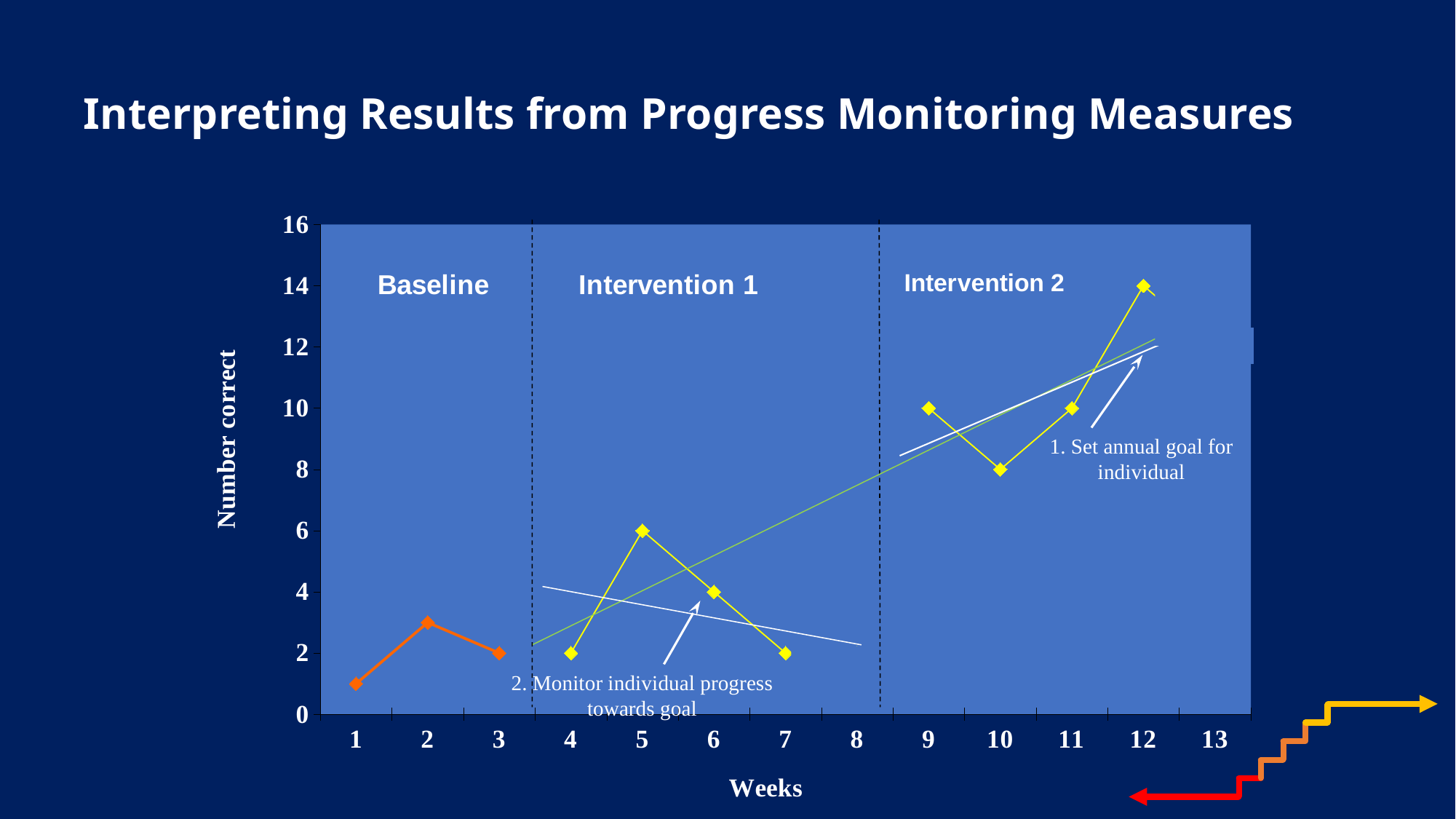
What is the number correct at week 12? 14 At which week is the number correct highest? 12 What is the number correct at week 10? 8 Is the number correct at week 2 greater or less than 4? less Which week has a higher number correct, week 9 or week 10? week 9 What is the difference between the number correct at week 12 and at week 10? 6 What is the number correct at week 5? 6 What kind of chart is shown on the slide? line chart Is the number correct at week 12 greater or less than 12? greater What is the label of the y axis? Number correct At which week is the number correct lowest? 1 What are the three phases labelled on the chart? Baseline, Intervention 1, Intervention 2